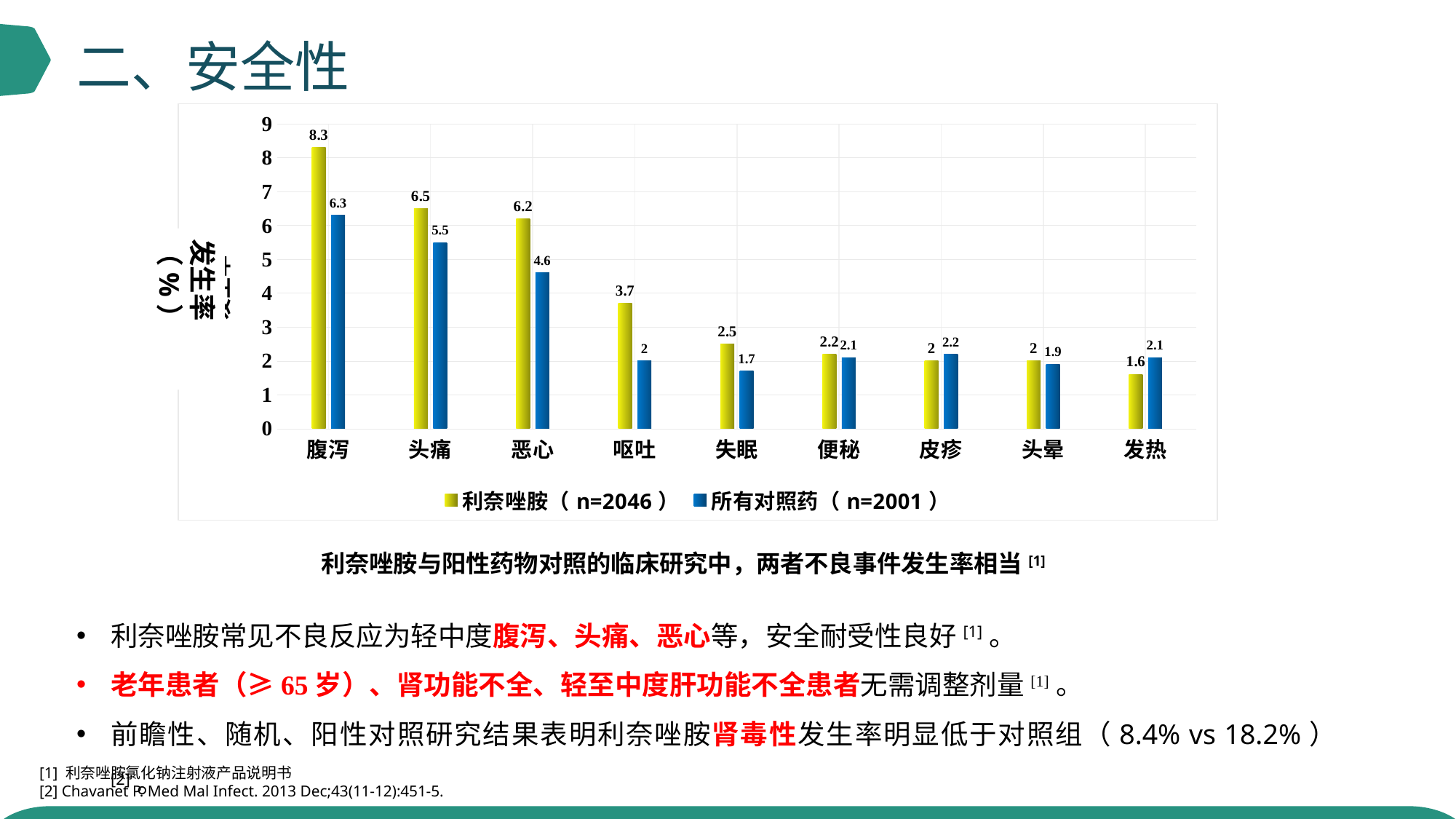
What is the sample size shown in the legend for 所有对照药? n=2001 How many series does the chart legend list? 2 What is the incidence rate of 腹泻 for 利奈唑胺（n=2046）? 8.3 For 发热, which series has the higher incidence rate, 利奈唑胺（n=2046） or 所有对照药（n=2001）? 所有对照药（n=2001） Is the 利奈唑胺（n=2046） value for 腹泻 greater or less than 8? greater What is the incidence rate of 恶心 for 所有对照药（n=2001）? 4.6 What is the incidence rate of 呕吐 for 利奈唑胺（n=2046）? 3.7 Which adverse event has the highest incidence rate for 利奈唑胺（n=2046）? 腹泻 What type of chart is shown on the slide? bar chart What is the difference between the 利奈唑胺 and 所有对照药 incidence rates for 头痛? 1 How many adverse-event categories are shown on the x axis of the chart? 9 Which adverse event has the lowest incidence rate for 利奈唑胺（n=2046）? 发热